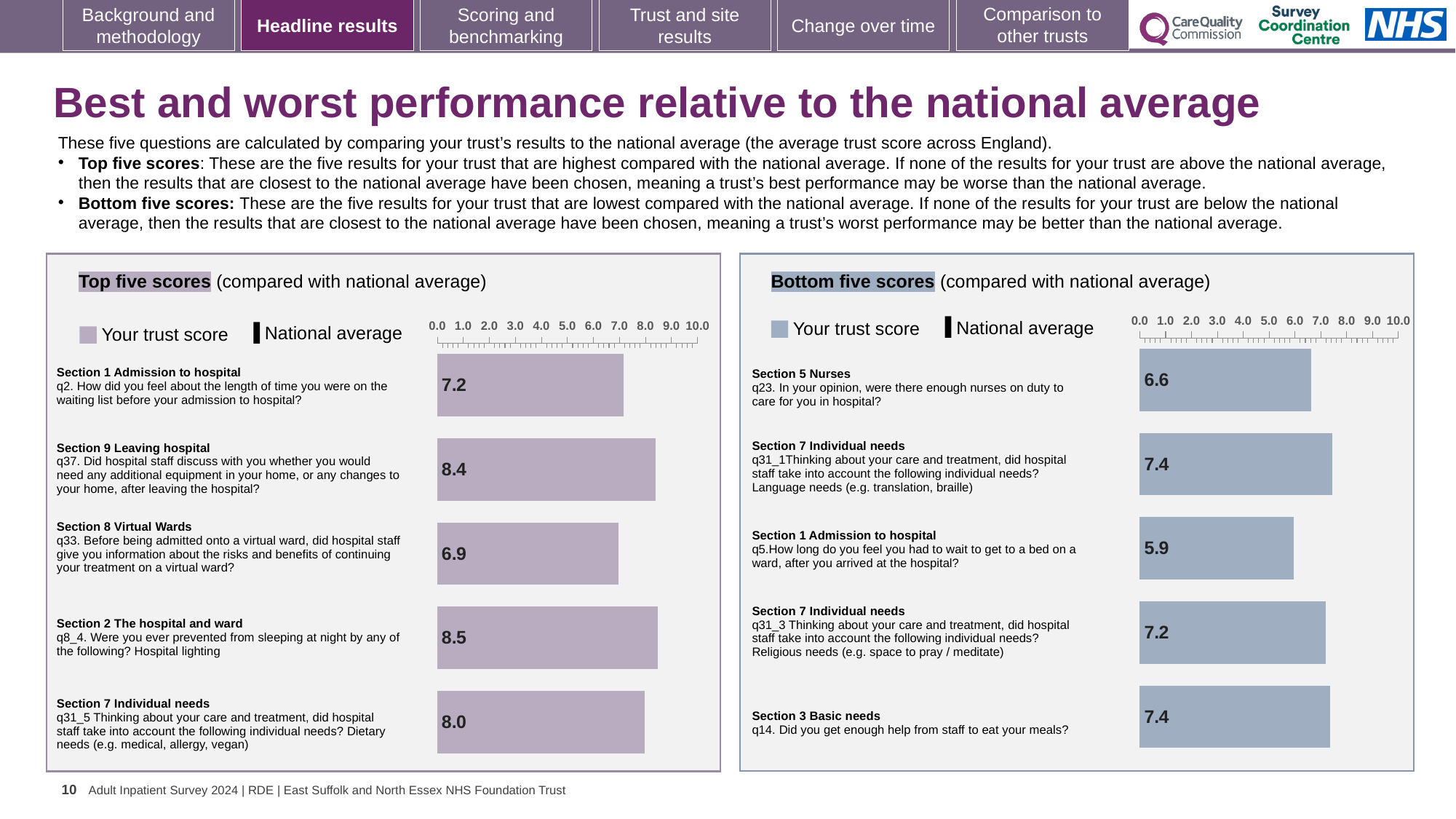
In the Bottom five scores chart, which has the larger trust score: q23 about enough nurses on duty or q31_3 about religious needs? q31_3 (7.2) In the Bottom five scores chart, which question has the lowest trust score? q5 (wait to get to a bed on a ward), 5.9 In the Bottom five scores chart, what is the trust score for q5 about how long you had to wait to get to a bed on a ward? 5.9 How many entries does the legend of the Top five scores chart list? 2 What kind of chart is the Bottom five scores chart? Bar chart How many bars are plotted in the Top five scores chart? 5 In the Top five scores chart, which question has the highest trust score? q8_4 (Hospital lighting), 8.5 In the Top five scores chart, what is the difference between the trust scores for q8_4 and q33? 1.6 In the Top five scores chart, which question has the lowest trust score? q33 (Virtual Wards), 6.9 In the Bottom five scores chart, what is the difference between the trust scores for q31_1 and q23? 0.8 In the Top five scores chart, what is the trust score for q2 about the length of time on the waiting list before admission to hospital? 7.2 In the Top five scores chart, what is the trust score for q31_5 about dietary needs? 8.0